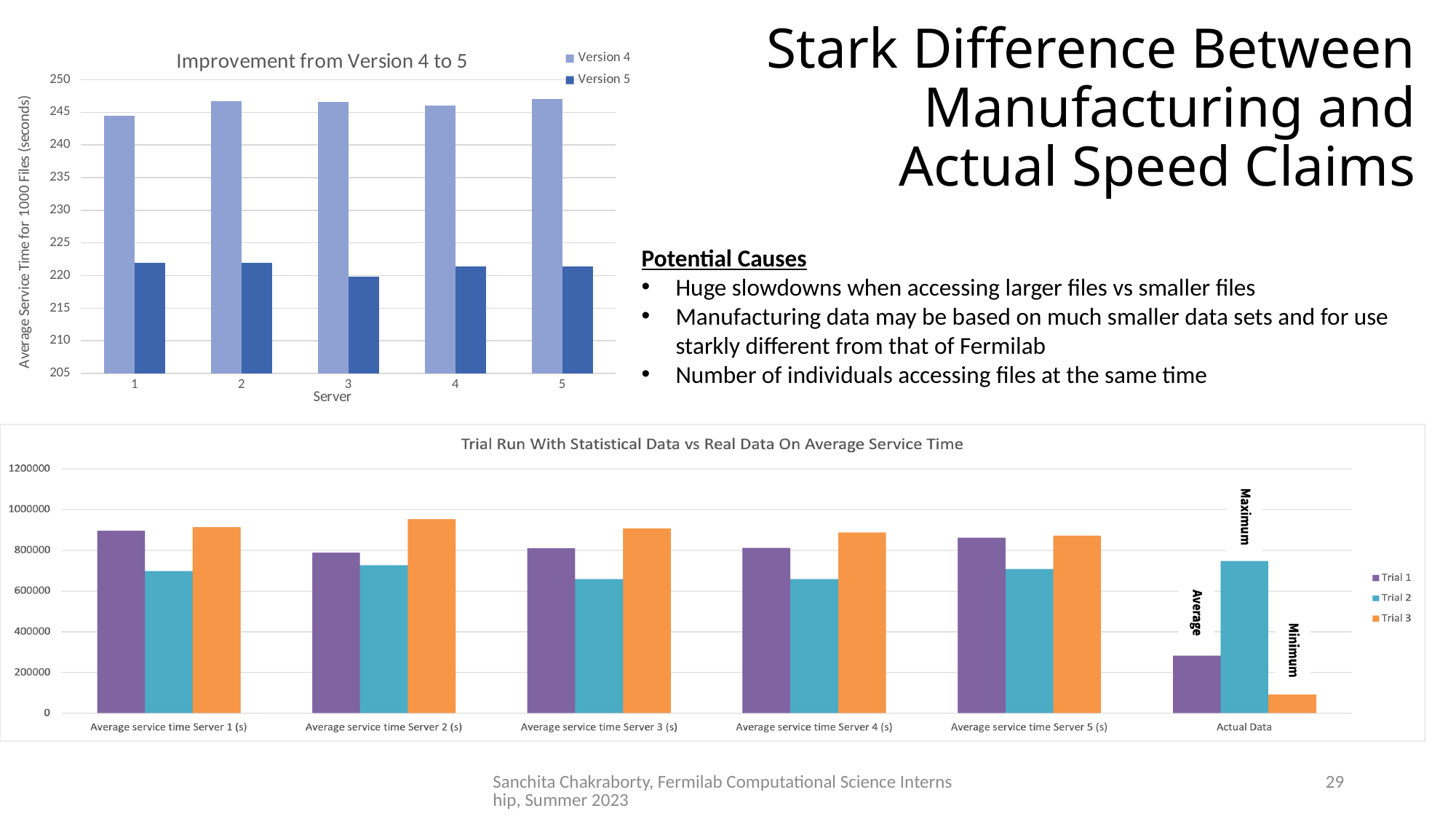
In the bottom chart 'Trial Run With Statistical Data vs Real Data On Average Service Time', what labels are written on the three 'Actual Data' bars? Average, Maximum, Minimum In the top chart 'Improvement from Version 4 to 5', how many series does the legend list? 2 In the bottom chart 'Trial Run With Statistical Data vs Real Data On Average Service Time', is the Trial 3 value for 'Average service time Server 2 (s)' greater or less than 800000? greater In the top chart 'Improvement from Version 4 to 5', is the Version 4 value for server 1 greater or less than 240? greater What kind of chart is the top chart titled 'Improvement from Version 4 to 5'? bar chart In the bottom chart 'Trial Run With Statistical Data vs Real Data On Average Service Time', which series has the highest value for 'Average service time Server 2 (s)'? Trial 3 In the bottom chart 'Trial Run With Statistical Data vs Real Data On Average Service Time', how many series does the legend list? 3 In the top chart 'Improvement from Version 4 to 5', is the Version 5 value for server 1 greater or less than 225? less In the bottom chart 'Trial Run With Statistical Data vs Real Data On Average Service Time', how many categories are shown on the x axis? 6 In the top chart 'Improvement from Version 4 to 5', which is larger for server 3: Version 4 or Version 5? Version 4 In the top chart 'Improvement from Version 4 to 5', how many servers are shown on the x axis? 5 What kind of chart is the bottom chart titled 'Trial Run With Statistical Data vs Real Data On Average Service Time'? bar chart